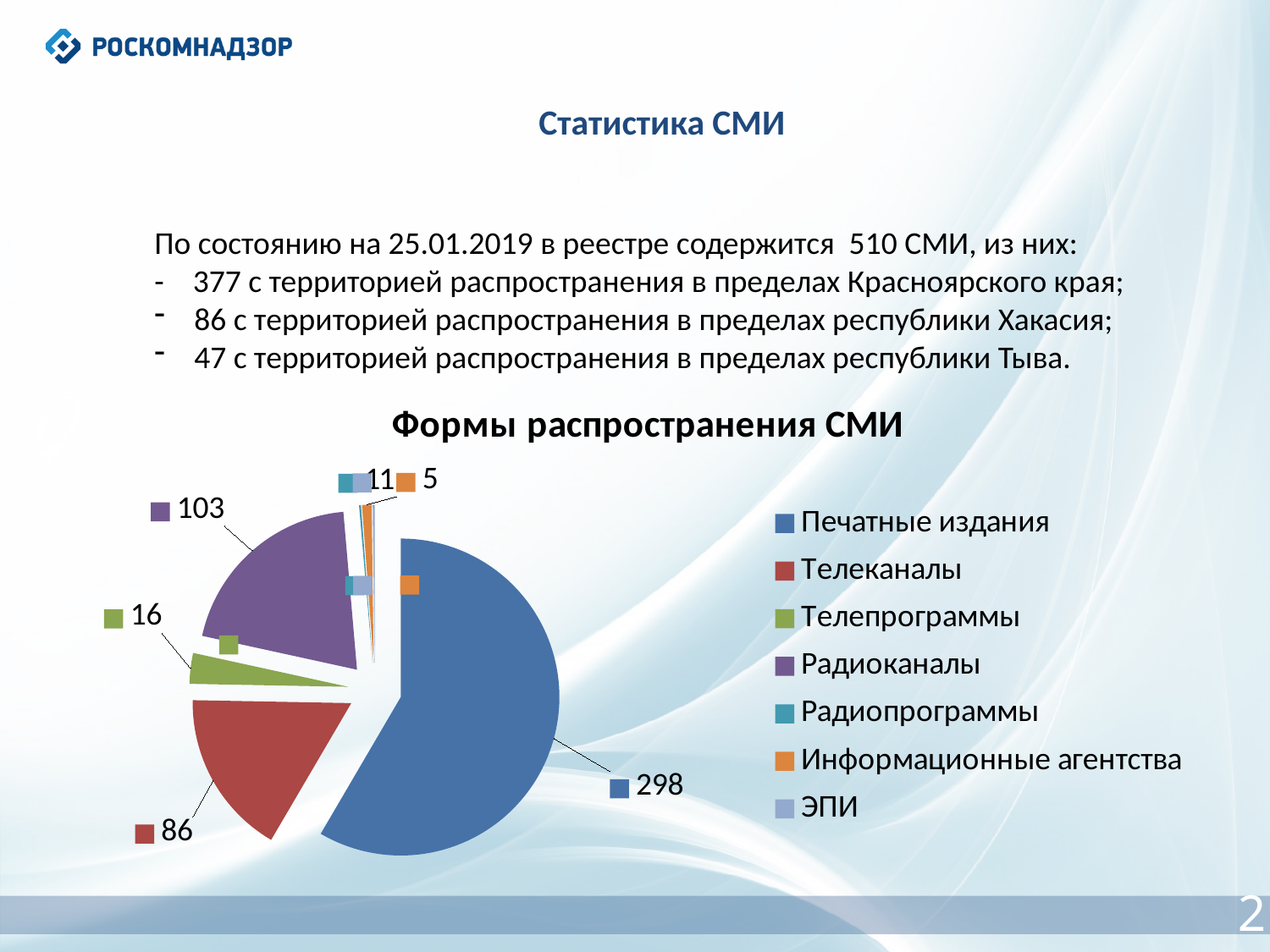
In the pie chart "Формы распространения СМИ", what colour is the slice for Телепрограммы? green In the pie chart "Формы распространения СМИ", which is larger: Радиоканалы or Телеканалы? Радиоканалы In the pie chart "Формы распространения СМИ", what is the value for Телеканалы? 86 What kind of chart is shown under the title "Формы распространения СМИ"? pie chart In the pie chart "Формы распространения СМИ", what is the value for Печатные издания? 298 How many categories does the legend of the pie chart "Формы распространения СМИ" list? 7 In the pie chart "Формы распространения СМИ", which category has the largest slice? Печатные издания In the pie chart "Формы распространения СМИ", what is the value for Телепрограммы? 16 In the pie chart "Формы распространения СМИ", what is the value for Радиоканалы? 103 In the pie chart "Формы распространения СМИ", what is the difference between Печатные издания and Радиоканалы? 195 In the pie chart "Формы распространения СМИ", what is the value for Радиопрограммы? 1 In the pie chart "Формы распространения СМИ", what is the value for Информационные агентства? 5